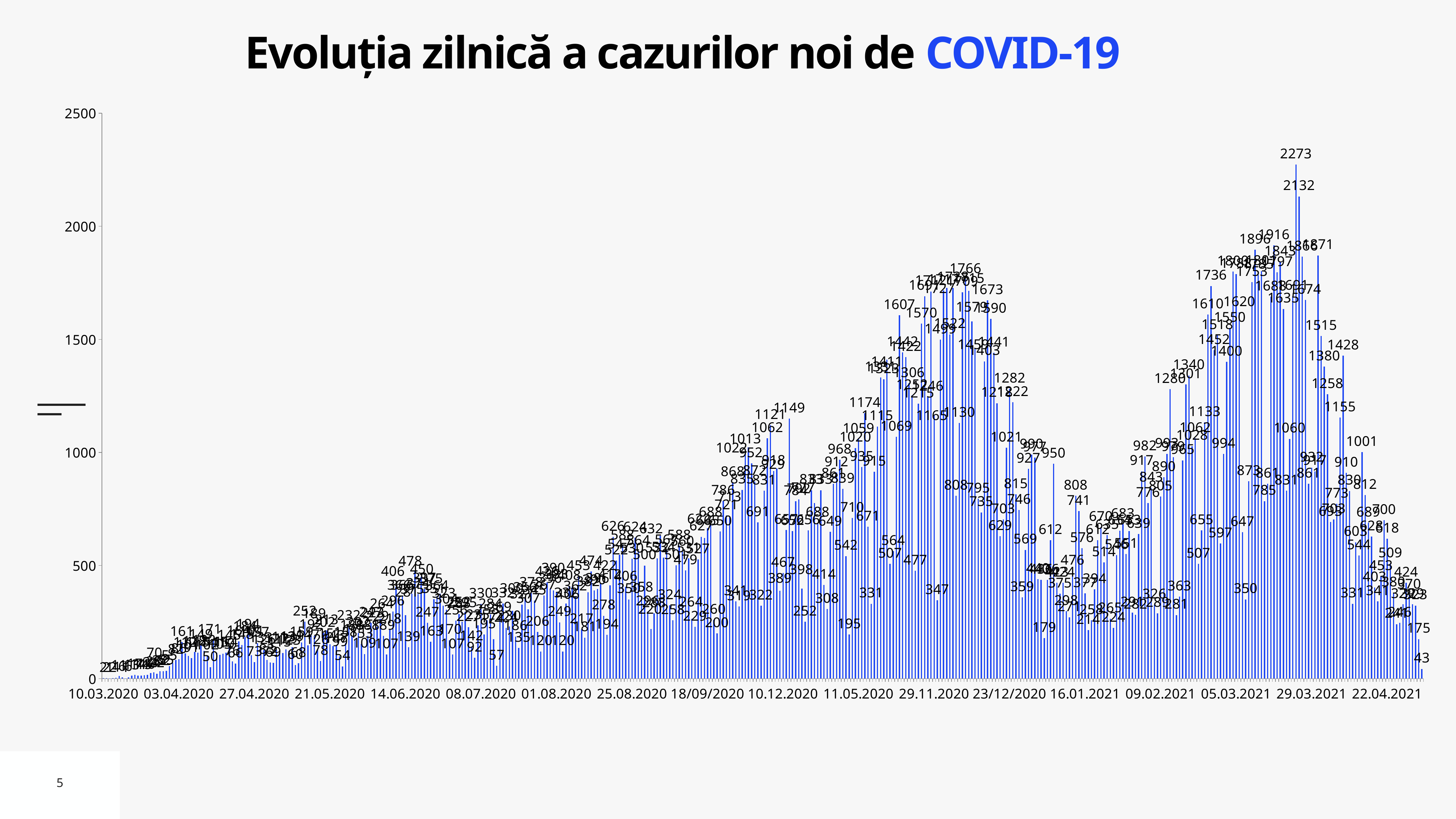
What is the second highest value labeled on the chart, next to the 2273 peak? 2132 Which is larger, the peak value 2273 or the value 2132 next to it? 2273 What is the maximum value shown on the vertical axis? 2500 What is the first date label on the horizontal axis? 10.03.2020 What is the difference between the two highest labeled values, 2273 and 2132? 141 What is the value labeled on the last bar at the right end of the chart? 43 What is the highest value labeled on the chart? 2273 What is the last date label on the horizontal axis? 22.04.2021 Is the value of the last bar on the right greater or less than 500? less Is the value of the tallest bar greater or less than 2000? greater What is the title of the chart on the slide? Evoluția zilnică a cazurilor noi de COVID-19 What kind of chart is shown on the slide? bar chart